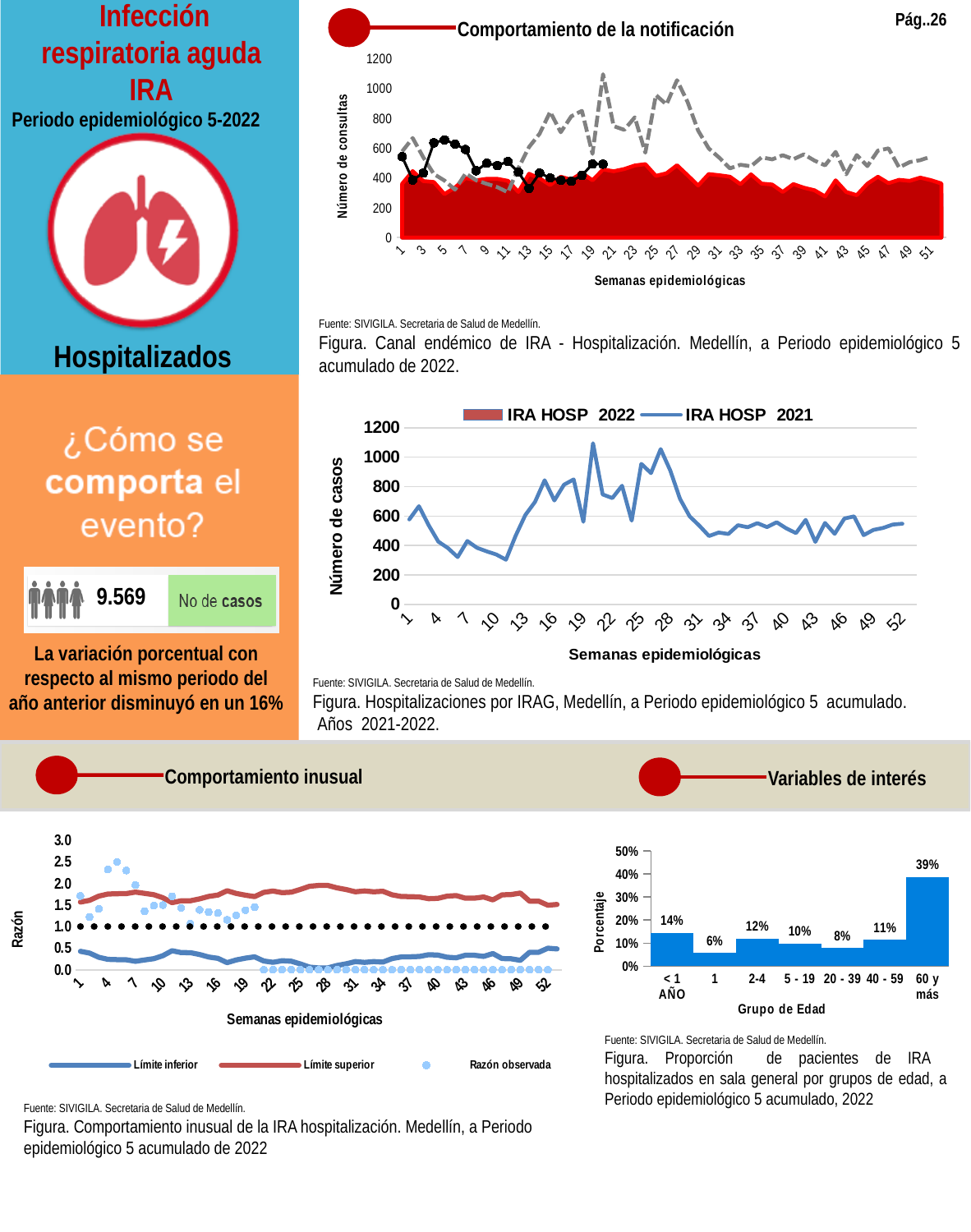
What kind of chart is the 'Grupo de Edad' chart at the bottom right? Bar chart How many series does the legend list in the 'IRA HOSP' line chart in the middle right? 2 In the 'IRA HOSP 2021' line chart (middle right), is the value at week 10 greater or less than 400? less In the bar chart by age group (bottom right), what is the value for the '< 1 AÑO' group? 14% How many age groups are shown in the bar chart at the bottom right? 7 In the bar chart by age group (bottom right), which is larger, the value for '2-4' or the value for '40 - 59'? 2-4 How many series does the legend list in the 'Comportamiento inusual' chart at the bottom left? 3 In the bar chart by age group (bottom right), which age group has the lowest percentage? 1 In the bar chart of proportion of hospitalized IRA patients by age group (bottom right), what is the value for the '60 y más' group? 39% In the bar chart by age group (bottom right), which age group has the highest percentage? 60 y más In the bar chart by age group (bottom right), what is the difference between the '60 y más' group and the '< 1 AÑO' group? 25% In the 'Comportamiento inusual' chart (bottom left), is the 'Razón observada' value at week 4 greater or less than 2.0? greater